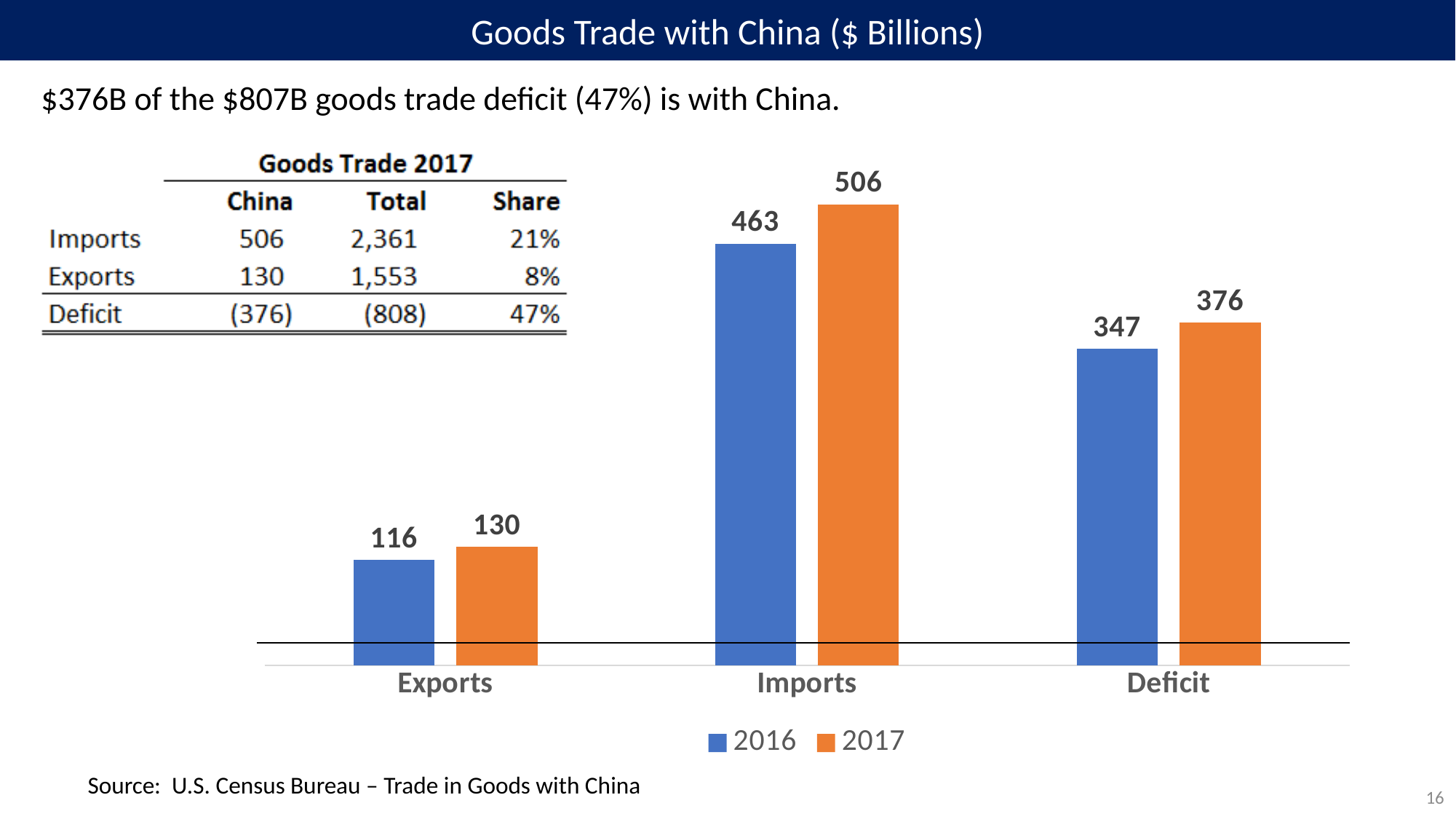
What is the difference between the 2017 and 2016 values for Imports? 43 Which category has the highest value in 2016? Imports Which category has the lowest value in 2017? Exports Which colour represents the 2017 series? Orange What is the value for Exports in 2016? 116 What is the value for Deficit in 2017? 376 What kind of chart is shown? Bar chart How many series does the legend list? 2 What is the value for Imports in 2017? 506 Which is larger, Exports in 2017 or Exports in 2016? Exports in 2017 What is the difference between the 2017 and 2016 values for Deficit? 29 How many categories are shown on the x axis? 3